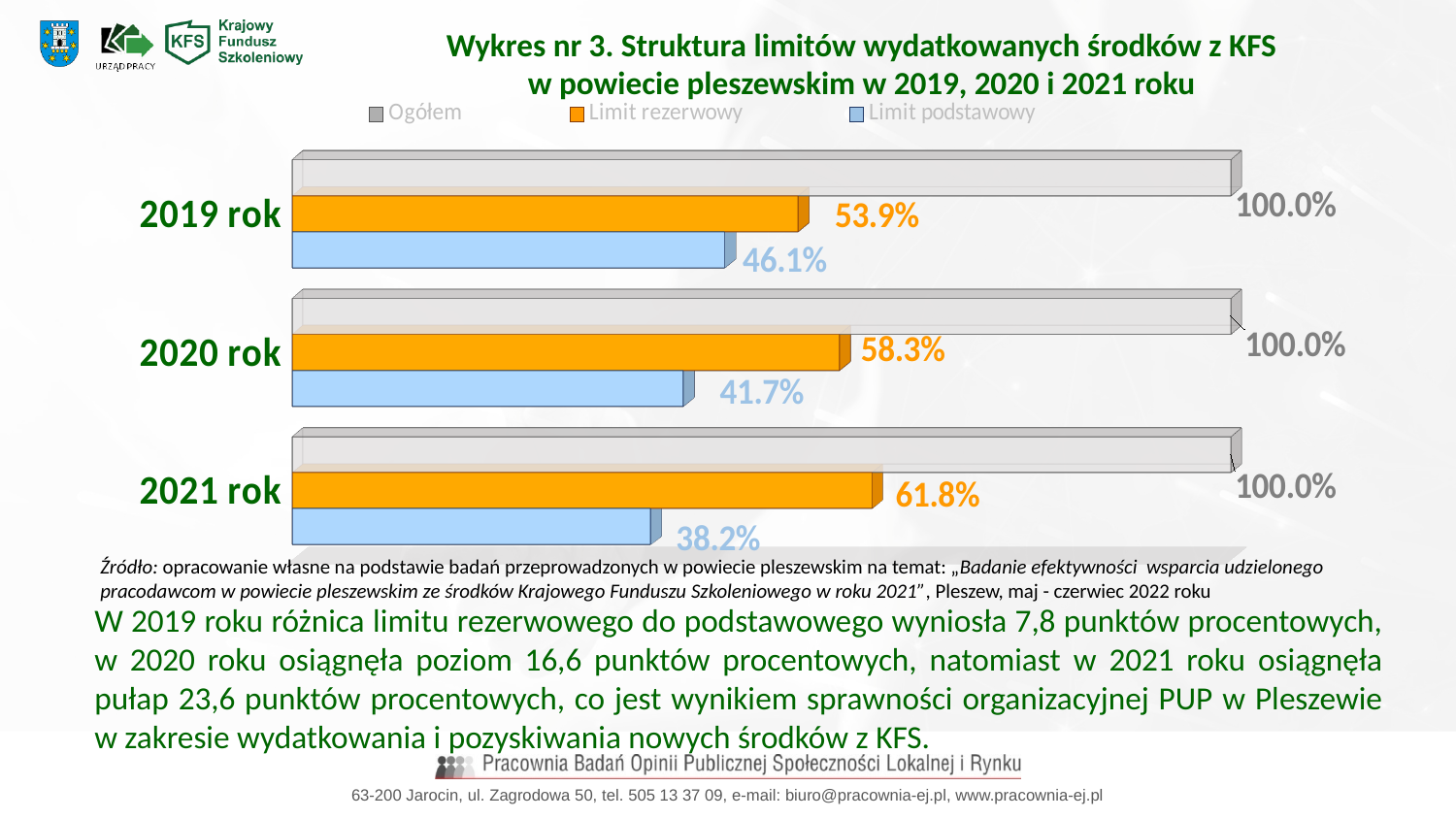
What is the difference between Limit rezerwowy and Limit podstawowy in 2020 rok? 16.6 percentage points How many years (categories) are shown on the chart? 3 What is the value of Limit podstawowy for 2021 rok? 38.2% How many series does the legend list? 3 Which year has the highest value for Limit rezerwowy? 2021 rok What is the value of Ogółem for 2020 rok? 100.0% What kind of chart is shown on the slide? Bar chart Which series is shown in orange in the legend? Limit rezerwowy Does the value of Limit rezerwowy rise or fall from 2019 rok to 2021 rok? Rise Which is larger in 2019 rok: Limit rezerwowy or Limit podstawowy? Limit rezerwowy Which year has the lowest value for Limit podstawowy? 2021 rok What is the value of Limit rezerwowy for 2019 rok? 53.9%